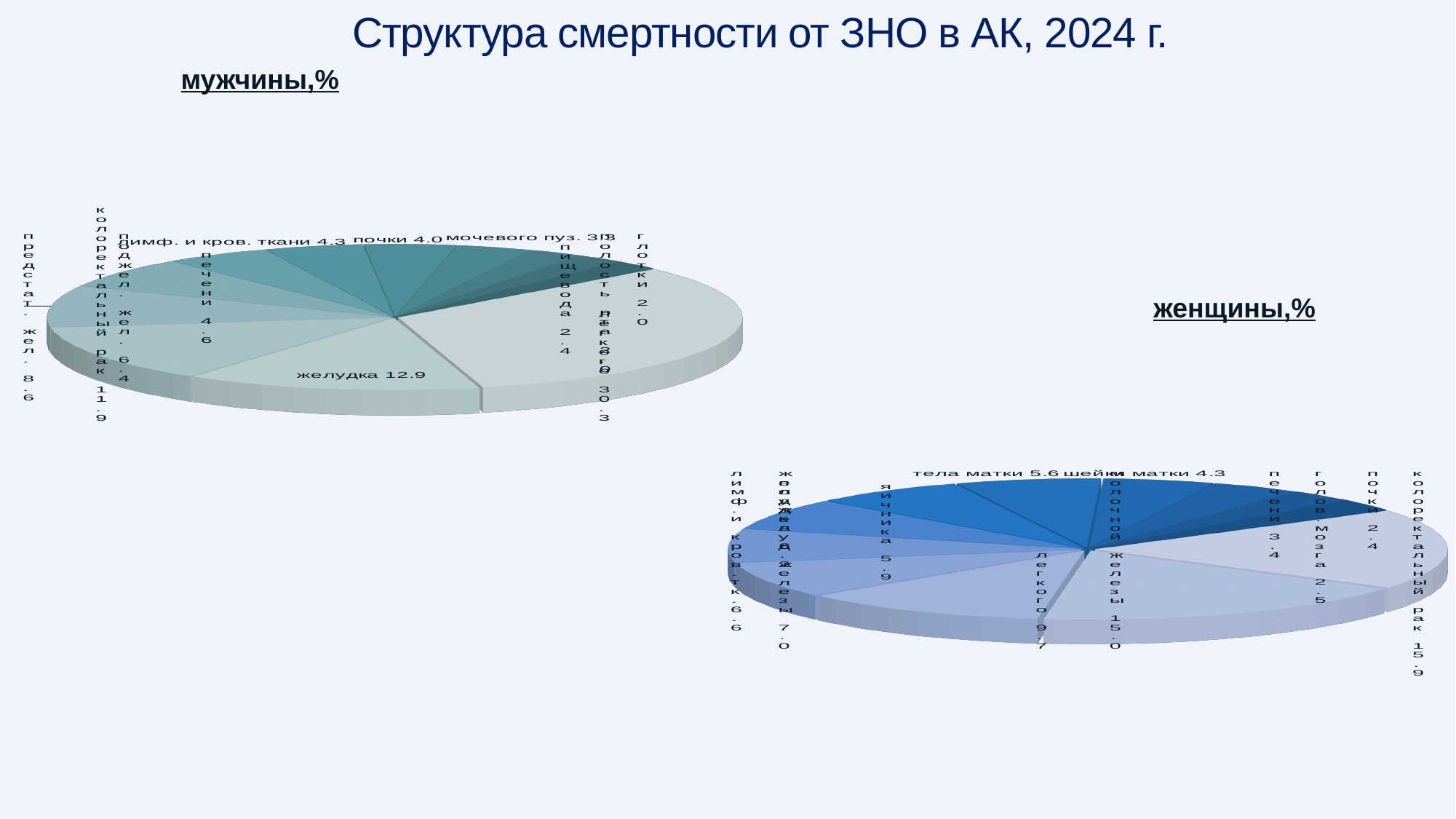
In the 'мужчины,%' chart, what is the value for предстат. жел.? 8.6 In the 'мужчины,%' chart, which category has the largest share? легкого In the 'мужчины,%' chart, what is the value for глотки? 2.0 In the 'женщины,%' chart, which is larger: колоректальный рак or молочной железы? колоректальный рак In the 'мужчины,%' chart, what is the difference between желудка (12.9) and колоректальный рак (11.9)? 1.0 What type of charts are shown on the slide? pie charts In the 'женщины,%' chart, what is the value for печени? 3.4 In the 'мужчины,%' chart, what is the value for желудка? 12.9 What is the title of the slide? Структура смертности от ЗНО в АК, 2024 г. In the 'женщины,%' chart, what is the difference between колоректальный рак (15.9) and молочной железы (15.0)? 0.9 Which chart shows a larger value for почки: 'мужчины,%' or 'женщины,%'? мужчины,% In the 'женщины,%' chart, what is the value for тела матки? 5.6